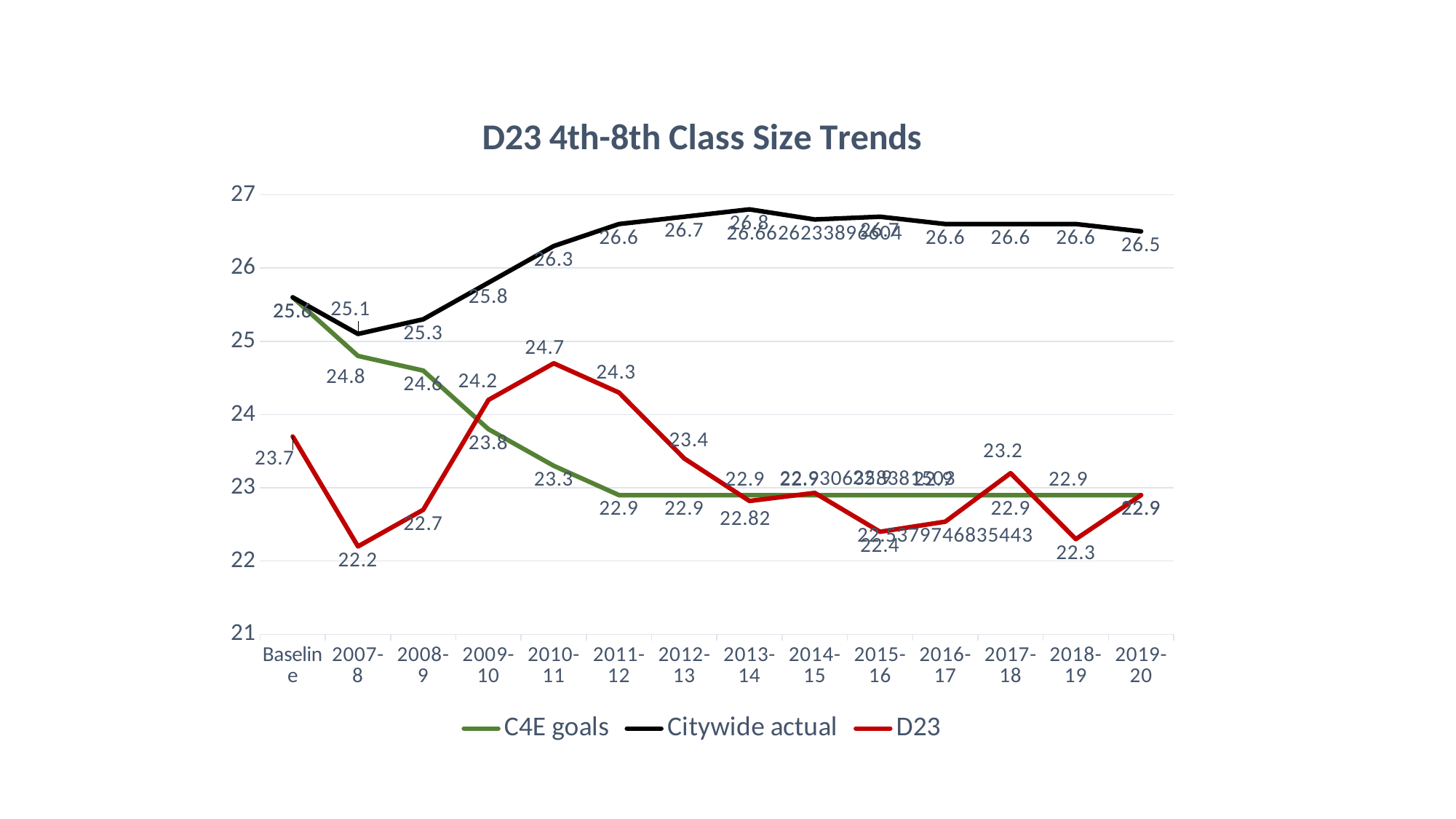
In which year does the D23 series reach its highest value? 2010-11 What kind of chart is shown on the slide? Line chart Is the Citywide actual value for 2010-11 greater or less than 26? greater In which year does the D23 series reach its lowest value? 2007-8 What is the C4E goals value for 2007-8? 24.8 What is the D23 value for 2010-11? 24.7 How many categories are shown on the x axis? 14 How many series does the legend list? 3 What is the difference between the D23 value in 2010-11 and in 2007-8? 2.5 What is the Citywide actual value for 2019-20? 26.5 What is the D23 value for 2013-14? 22.82 Which is larger in 2017-18, the D23 value or the C4E goals value? D23